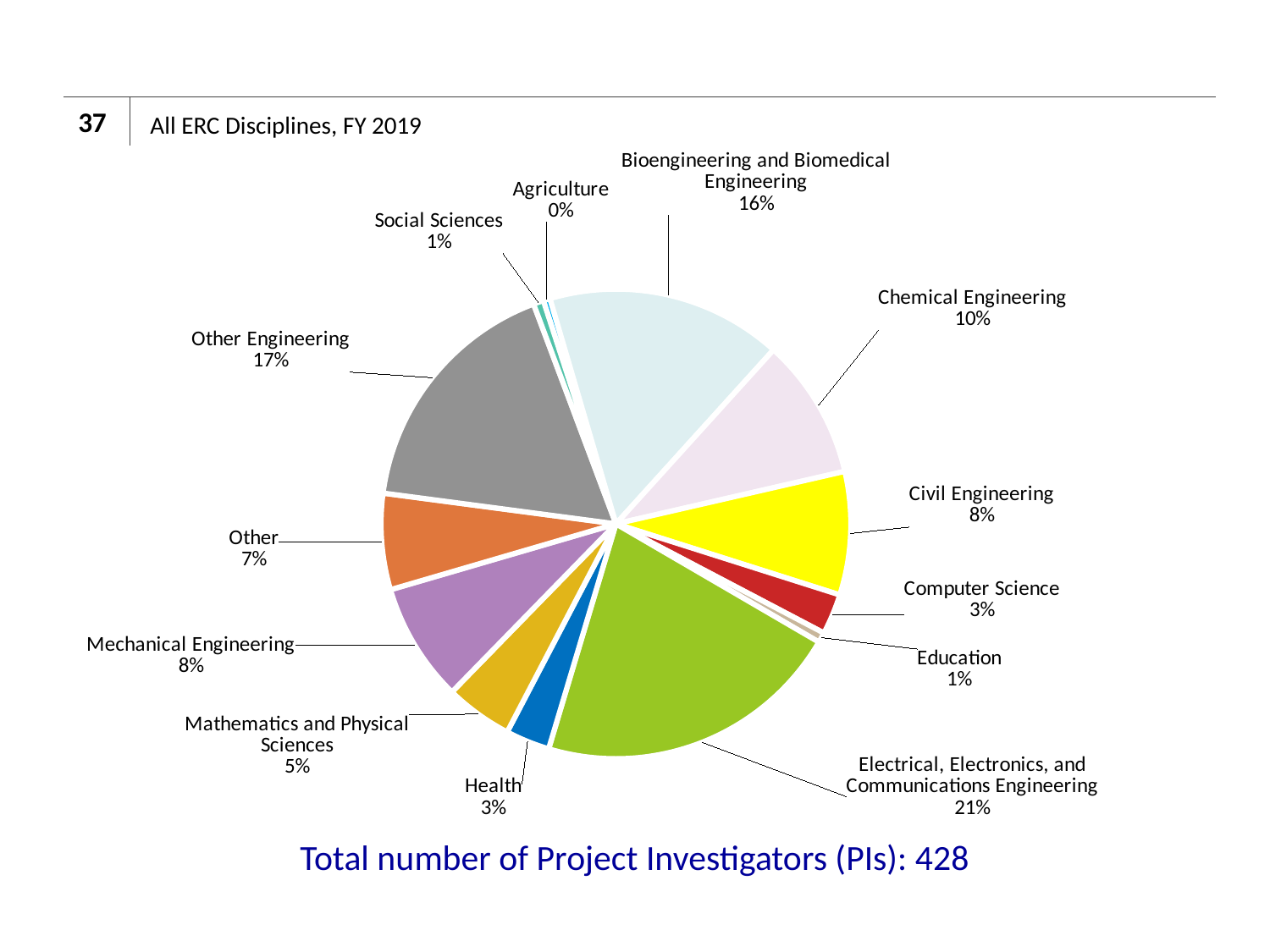
Which discipline has the largest share of the pie? Electrical, Electronics, and Communications Engineering What percentage is shown for Mathematics and Physical Sciences? 5% Which has a larger share, Chemical Engineering or Civil Engineering? Chemical Engineering What is the title of the chart? All ERC Disciplines, FY 2019 What is the total number of Project Investigators (PIs) stated below the chart? 428 What percentage is shown for Chemical Engineering? 10% How many discipline categories are shown in the pie chart? 13 What share of the pie does Electrical, Electronics, and Communications Engineering represent? 21% Which discipline has the smallest share of the pie? Agriculture What type of chart is shown on the slide? Pie chart What percentage is shown for Other Engineering? 17% What is the difference in percentage points between Other Engineering and Bioengineering and Biomedical Engineering? 1 percentage point